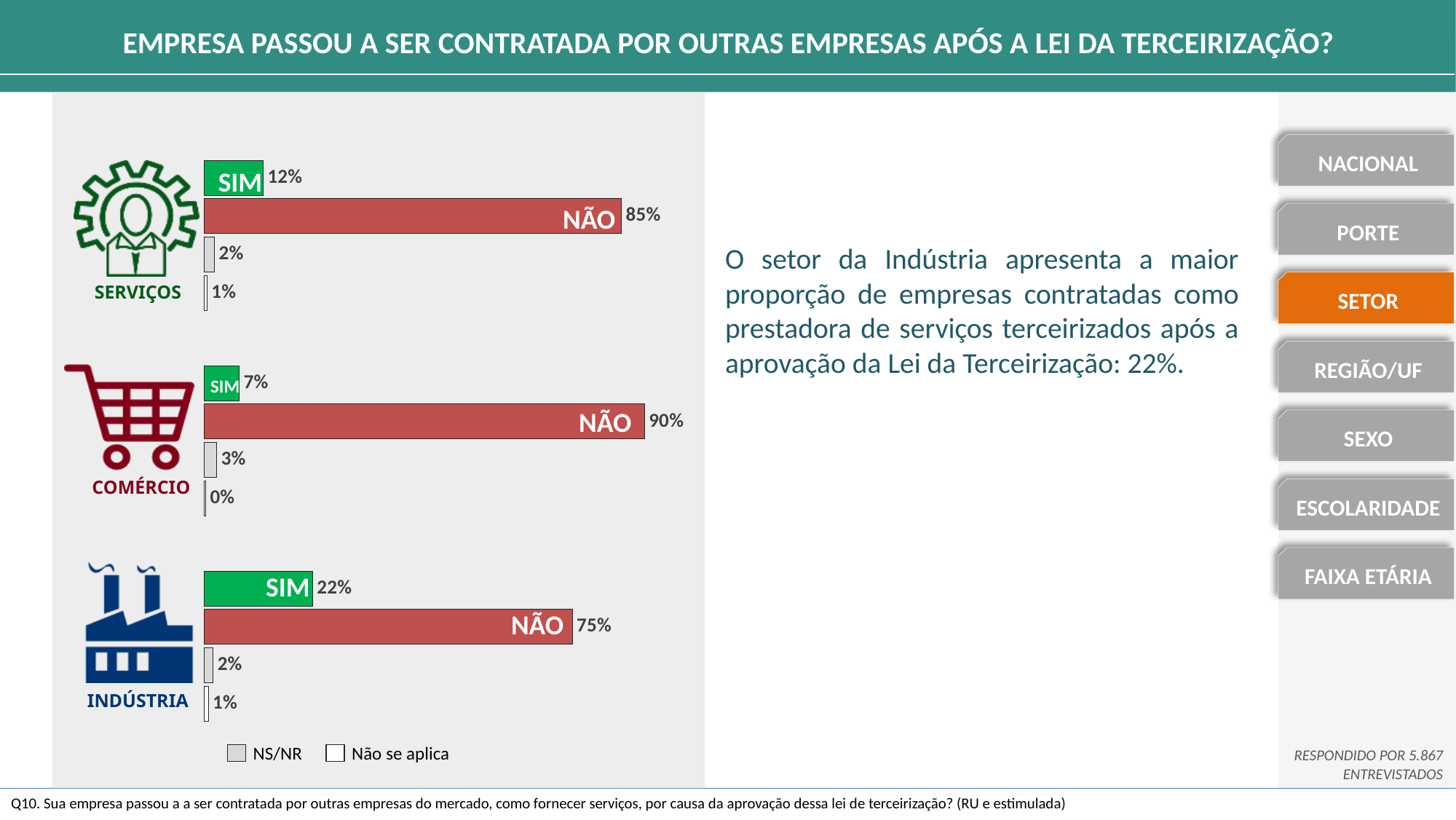
In the COMÉRCIO chart, what percentage answered NÃO? 90% Across the three sector charts, which sector has the lowest NÃO percentage? INDÚSTRIA In the INDÚSTRIA chart, what percentage answered SIM? 22% What type of chart is used to show the responses for each sector? Bar chart In the SERVIÇOS chart, what is the difference between the NÃO and SIM percentages? 73% Which is larger: the SIM percentage for SERVIÇOS or the SIM percentage for COMÉRCIO? SERVIÇOS Across the three sector charts, which sector has the highest SIM percentage? INDÚSTRIA In the INDÚSTRIA chart, what is the value for Não se aplica? 1% How many bars does each sector chart show? 4 What are the two categories listed in the legend at the bottom of the charts? NS/NR and Não se aplica In the SERVIÇOS chart, what percentage answered SIM? 12% In the COMÉRCIO chart, what is the value for NS/NR? 3%